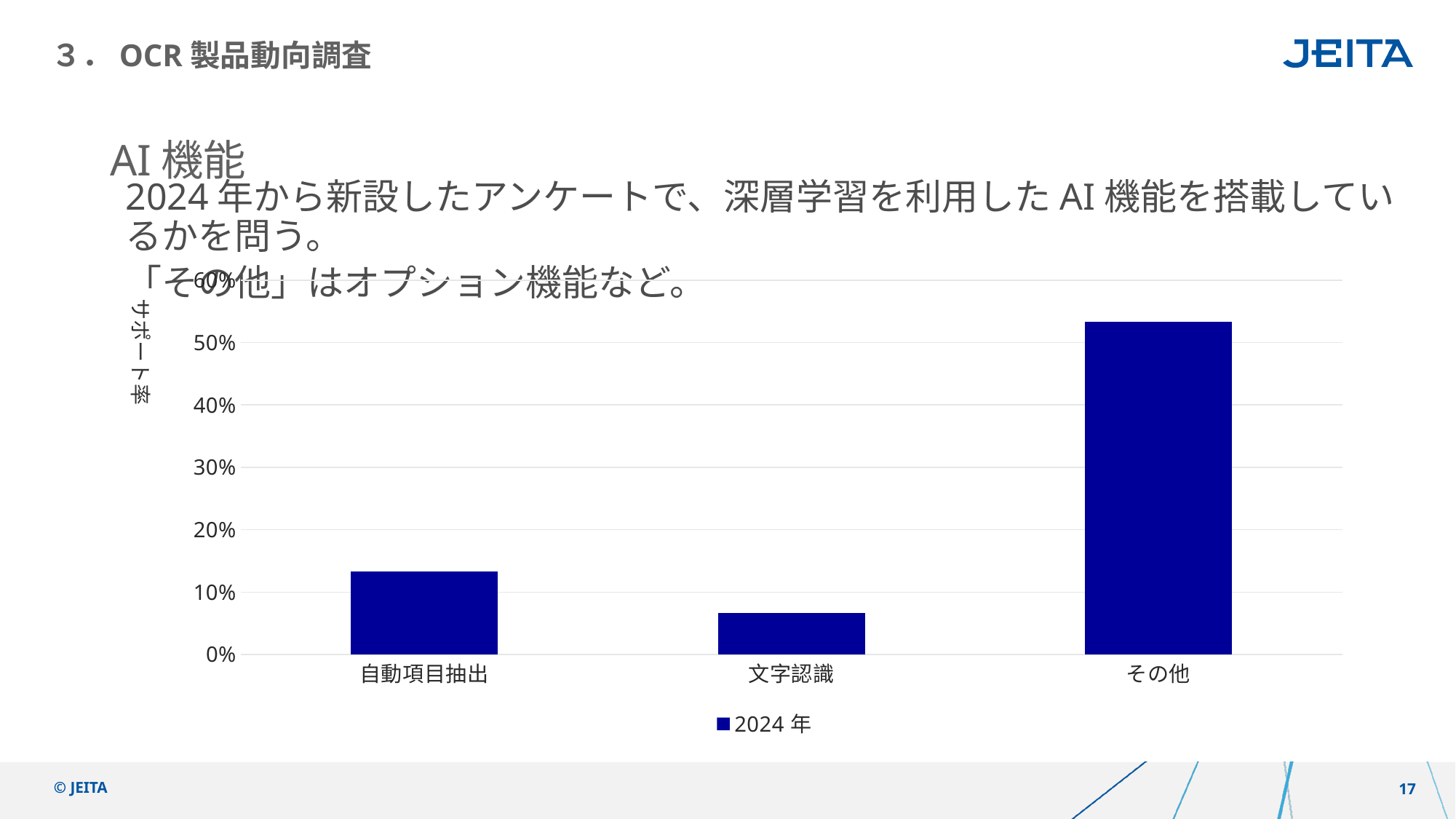
Which category has the highest value in the chart? その他 What series name is shown in the chart's legend? 2024年 Is the value for 文字認識 greater or less than 10%? less How many categories are shown on the x axis of the chart? 3 Is the value for その他 greater or less than 50%? greater Which category has the lowest value in the chart? 文字認識 What kind of chart is shown on the slide? bar chart How many series does the chart's legend list? 1 Which is larger, the value for 自動項目抽出 or the value for 文字認識? 自動項目抽出 Is the value for その他 greater or less than 60%? less What is the highest value shown on the chart's y axis? 60%